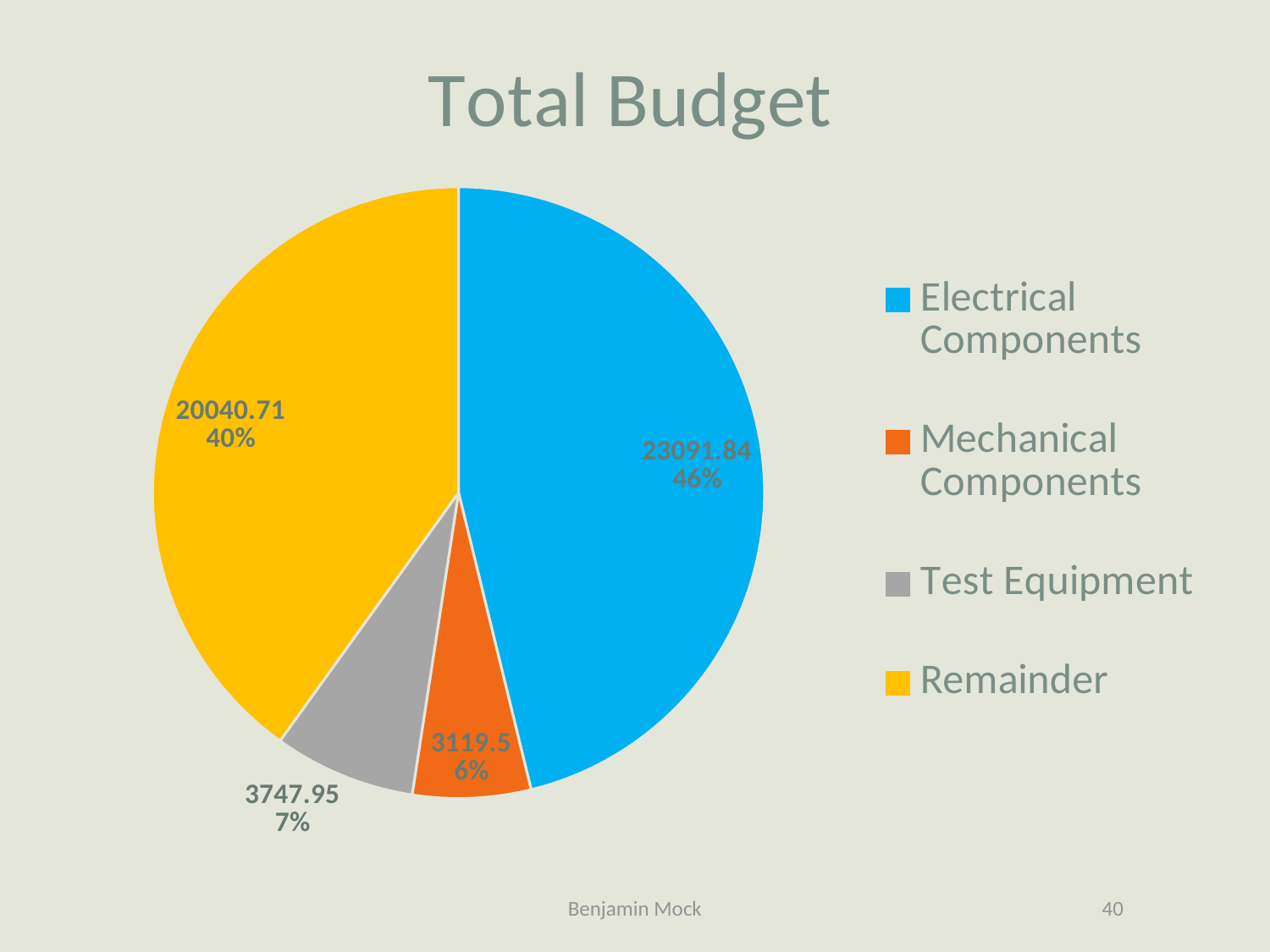
What is the difference between the values for Electrical Components and Remainder? 3051.13 What is the value for Electrical Components? 23091.84 How many categories does the pie chart have? 4 What is the value for Mechanical Components? 3119.5 What is the value for Test Equipment? 3747.95 What share of the pie does Remainder represent? 40% Which category has the largest slice? Electrical Components What is the value for Remainder? 20040.71 What type of chart is shown on the slide? Pie chart Which category has the smallest slice? Mechanical Components What share of the pie does Electrical Components represent? 46% What is the title of the chart? Total Budget